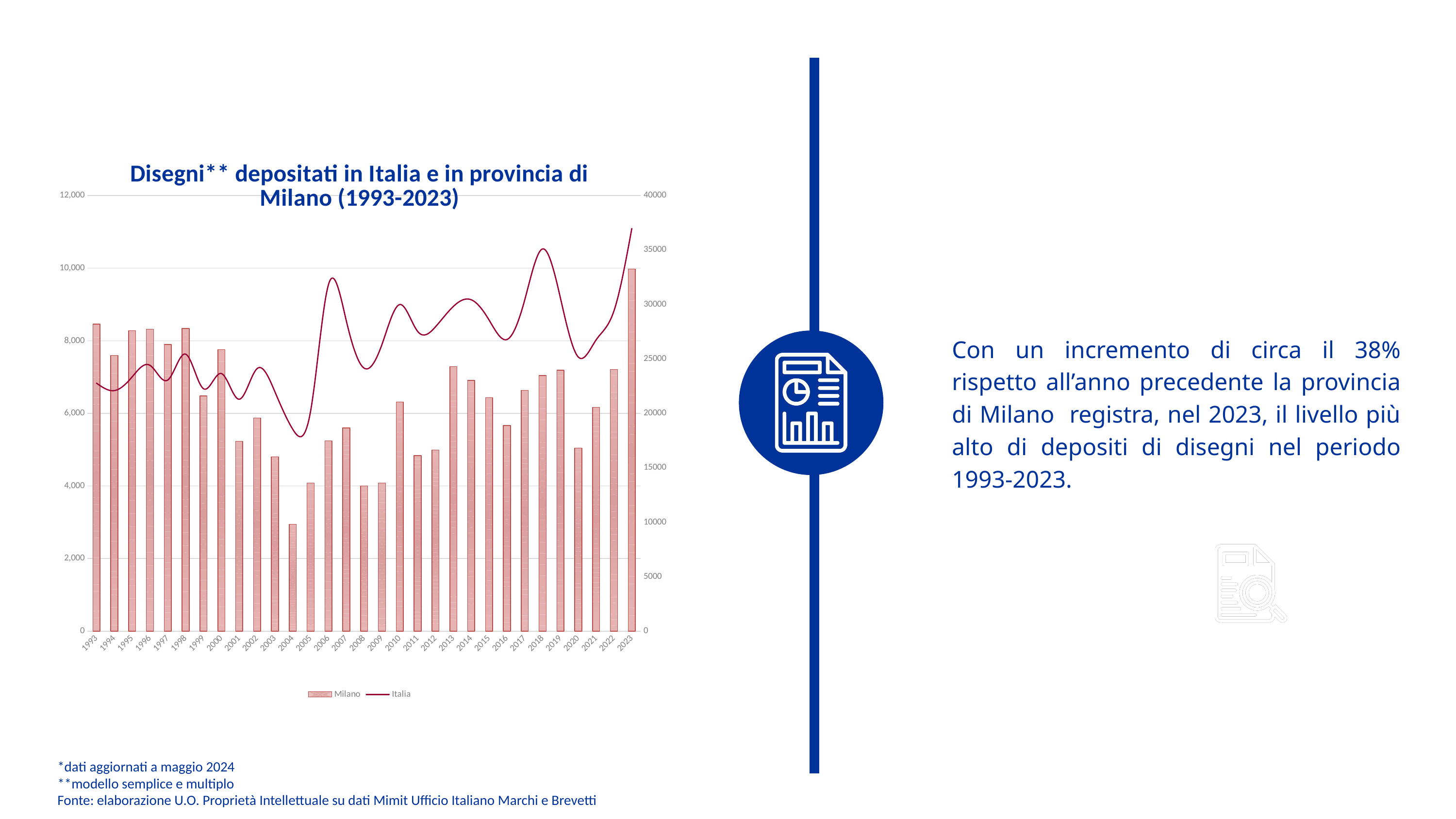
In which year does the Italia line reach its lowest point? 2004 How many series does the chart legend list? 2 What is the title of the chart? Disegni** depositati in Italia e in provincia di Milano (1993-2023) How many years are shown on the x axis of the chart? 31 Is the Milano value for 2023 greater or less than 8,000? greater Which year has the larger Milano value, 2022 or 2023? 2023 Which series is plotted as bars in the chart? Milano Is the Milano value for 2004 greater or less than 4,000? less In which year is the Milano bar highest? 2023 What kind of chart is shown on the slide? A combined bar and line chart Is the Italia value for 2023 greater or less than 35000? greater In which year is the Milano bar lowest? 2004